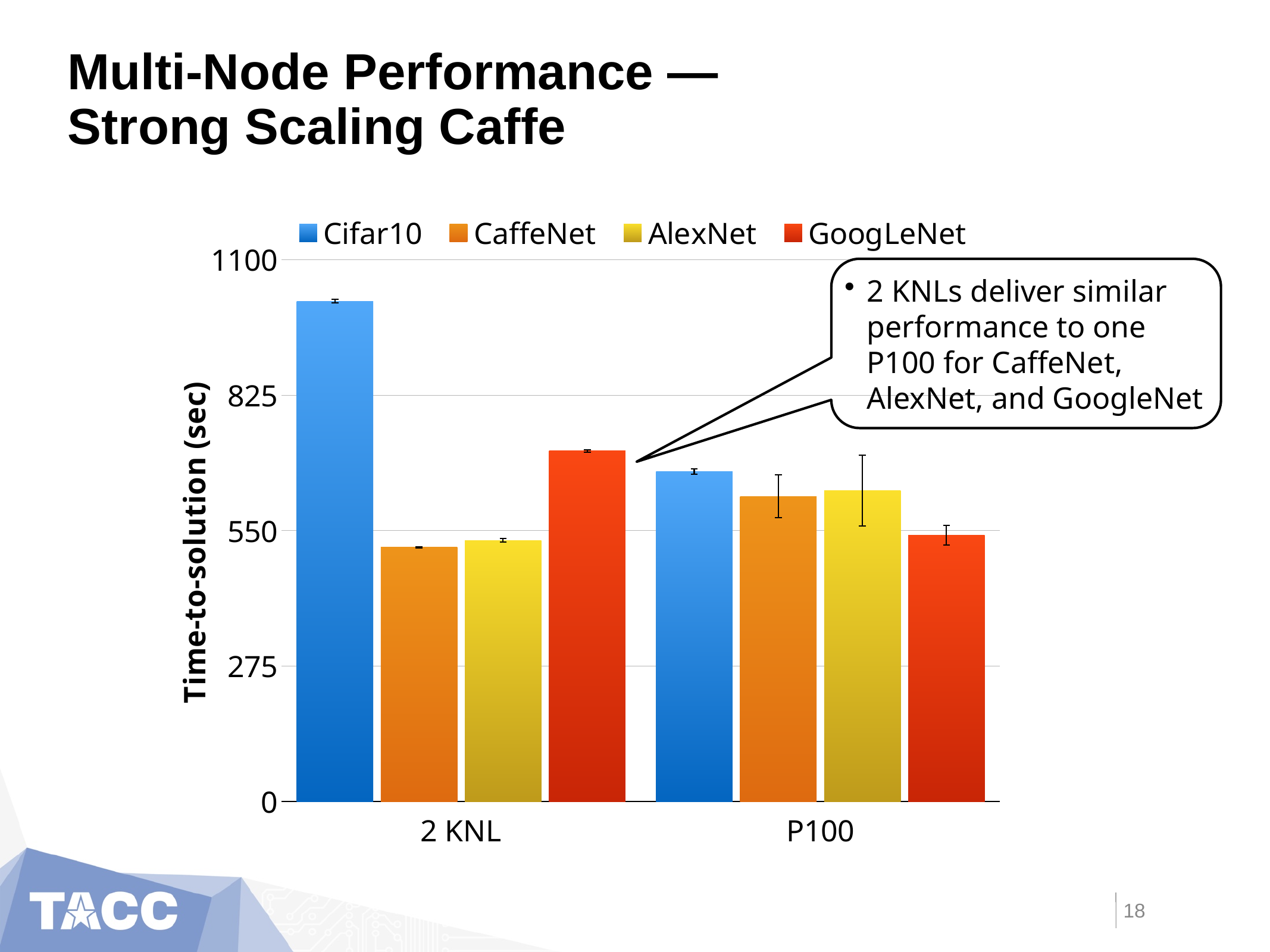
How many series does the legend list? 4 Which series has the highest time-to-solution for 2 KNL? Cifar10 Is the value for Cifar10 at P100 greater or less than 550? greater What is the label of the y axis? Time-to-solution (sec) Is the value for Cifar10 at 2 KNL greater or less than 825? greater What kind of chart is shown on the slide? bar chart How many categories are shown on the x axis? 2 Is the value for CaffeNet at 2 KNL greater or less than 550? less Which series has the lowest time-to-solution for P100? GoogLeNet Which is larger, the Cifar10 value for 2 KNL or for P100? 2 KNL Which series has the highest time-to-solution for P100? Cifar10